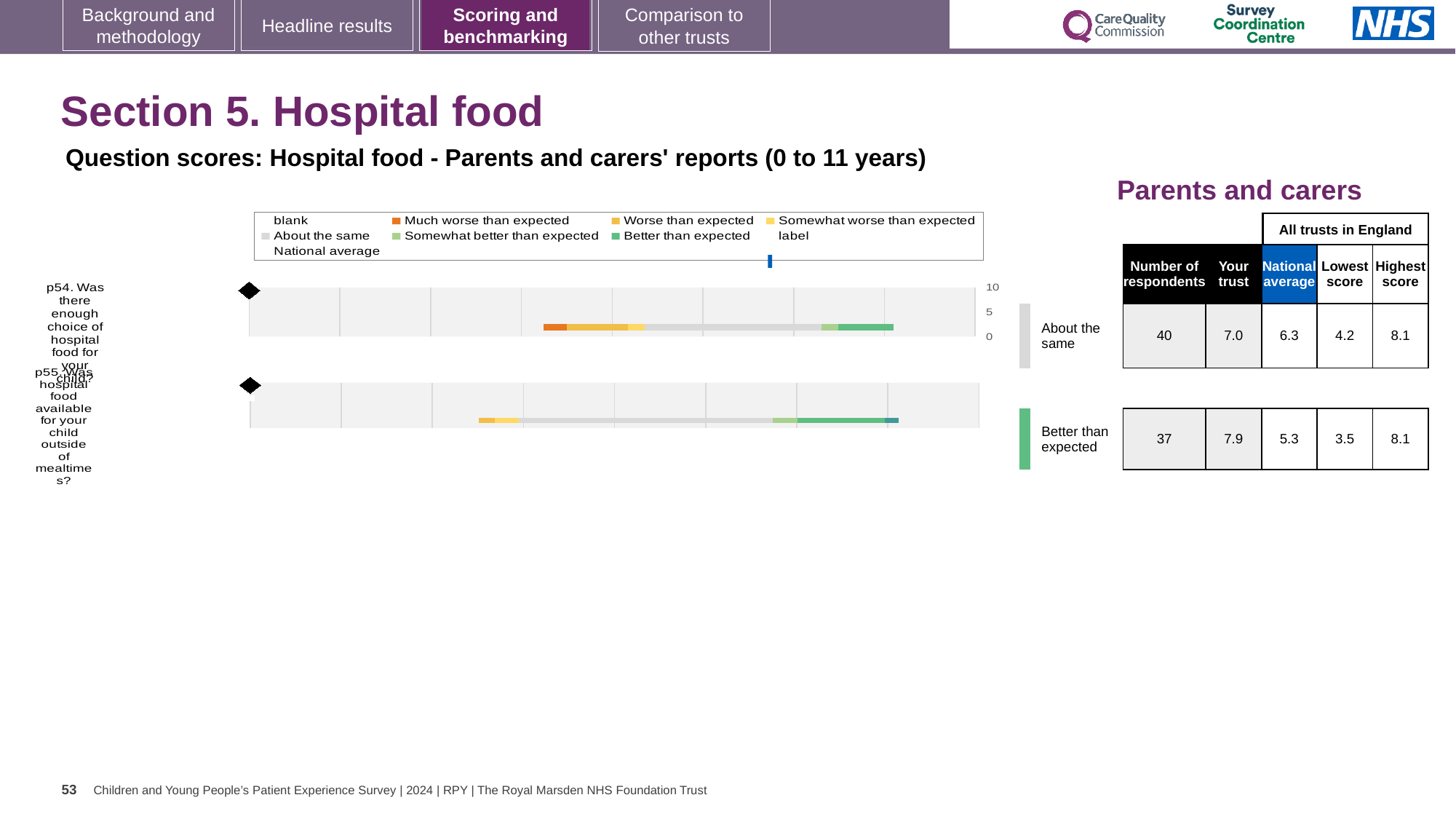
What is the national average score for p55? 5.3 What is the 'Your trust' score for p54 (enough choice of hospital food)? 7.0 What kind of chart is used to show the question scores for p54 and p55? bar chart What is the national average score for p54? 6.3 Which question has the higher 'Your trust' score, p54 or p55? p55 What is the difference between the 'Your trust' score and the national average for p54? 0.7 What is the difference between the 'Your trust' score and the national average for p55? 2.6 How many respondents answered p54? 40 What is the lowest score among all trusts in England for p55? 3.5 Which benchmark category is p55 placed in? Better than expected What is the 'Your trust' score for p55 (hospital food available outside of mealtimes)? 7.9 How many questions (rows) are plotted in the chart? 2